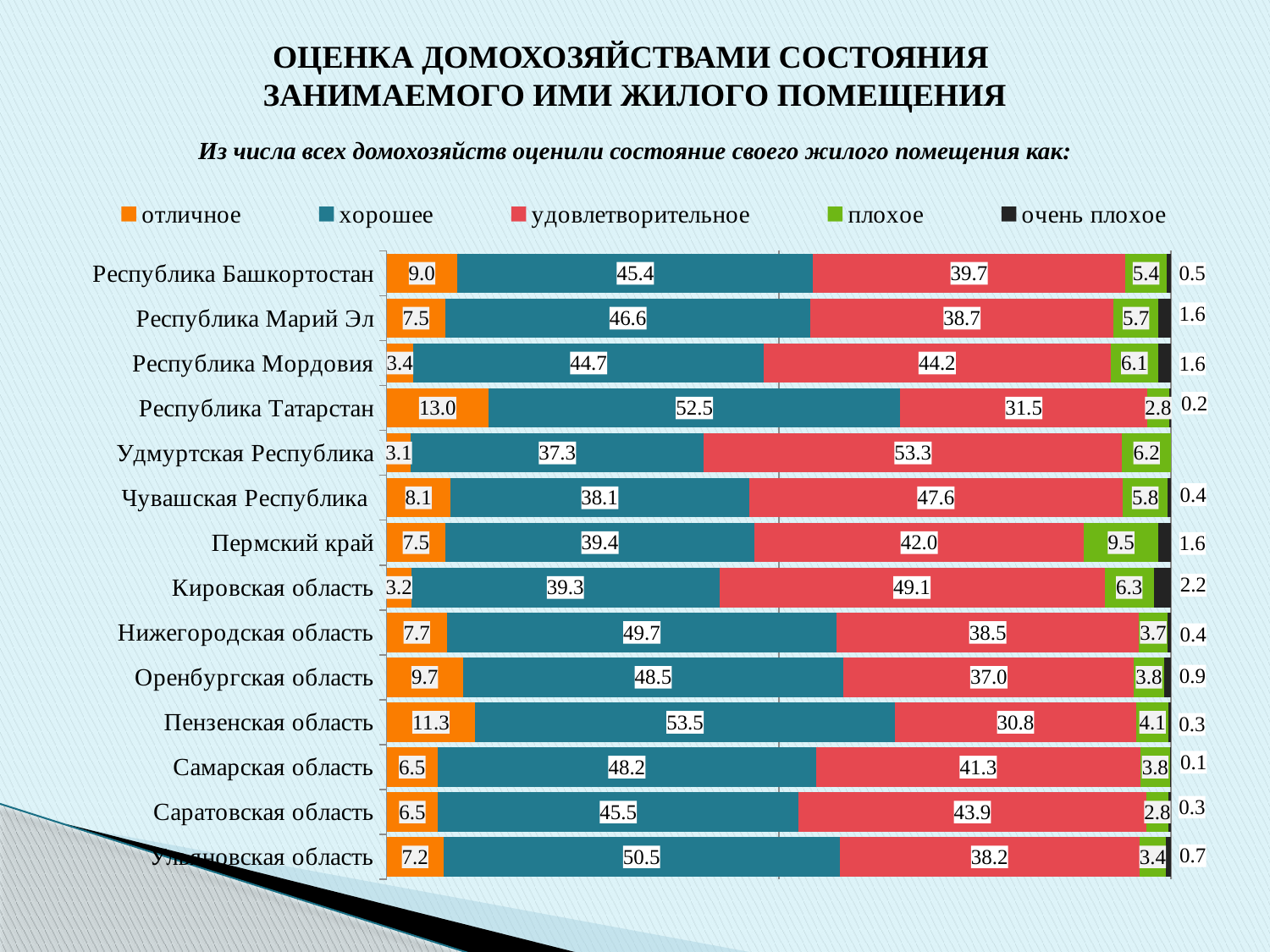
How many series does the legend list? 5 Which is larger: the "удовлетворительное" value for Республика Мордовия or for Республика Татарстан? Республика Мордовия What is the value for "отличное" for Республика Татарстан? 13.0 Which region has the highest value for "хорошее"? Пензенская область Which region has the highest value for "отличное"? Республика Татарстан What is the value for "удовлетворительное" for Удмуртская Республика? 53.3 How many regions are shown in the chart? 14 What is the difference between the "отличное" values for Республика Татарстан and Удмуртская Республика? 9.9 What is the value for "очень плохое" for Кировская область? 2.2 What kind of chart is shown on the slide? stacked bar chart Which region has the lowest value for "отличное"? Удмуртская Республика What is the value for "плохое" for Пермский край? 9.5